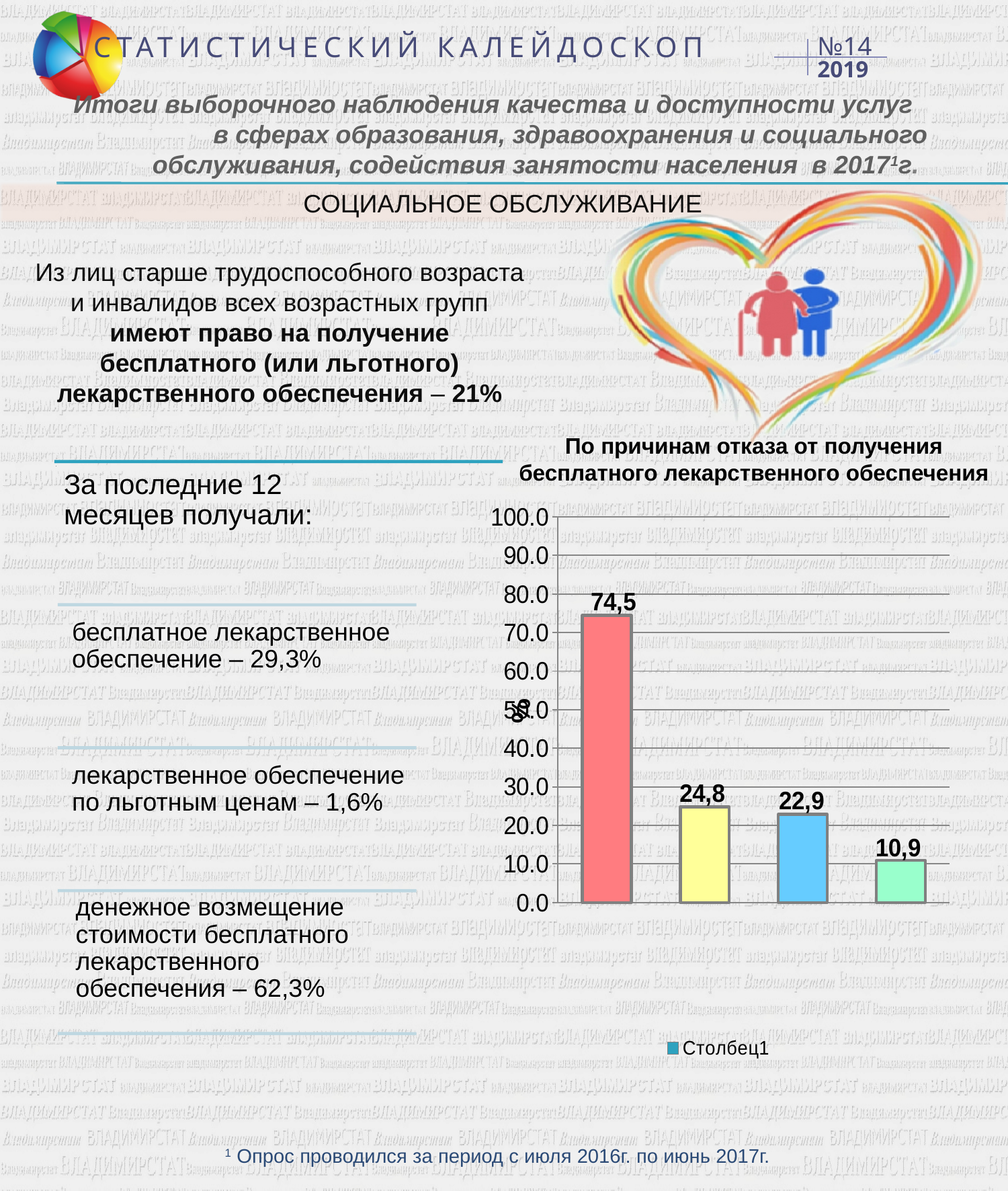
What value is printed on the blue bar (third from the left)? 22,9 Is the value of the red bar greater or less than 70.0? greater Do the bar values rise or fall from left to right across the chart? fall What is the value shown on the shortest bar of the chart? 10,9 What is the difference between the first bar (74,5) and the second bar (24,8)? 49,7 What kind of chart is shown on the slide? bar chart How many bars does the chart contain? 4 What is the legend entry shown below the chart? Столбец1 Which is larger: the value of the yellow bar or the value of the blue bar? the yellow bar (24,8) What is the value shown on the tallest bar of the chart? 74,5 How many series does the chart legend list? 1 What value is printed on the second bar from the left (the yellow bar)? 24,8